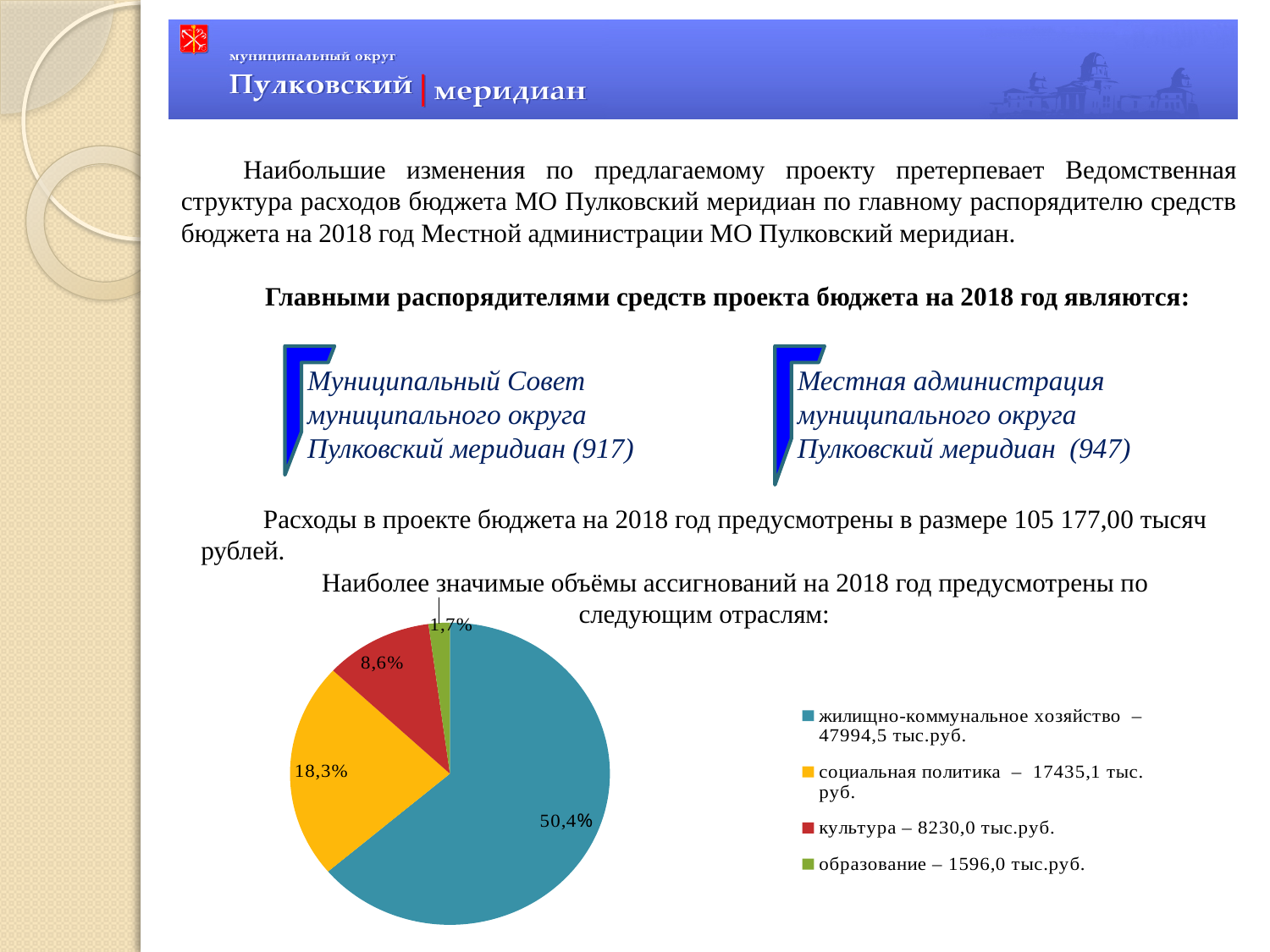
What is the difference in percentage points between the жилищно-коммунальное хозяйство slice and the социальная политика slice? 32,1% Which category has the smallest slice in the pie chart? образование What share of the pie does образование have? 1,7% How many slices does the pie chart have? 4 Which category has the largest slice in the pie chart? жилищно-коммунальное хозяйство Which slice is larger: социальная политика or культура? социальная политика What share of the pie does жилищно-коммунальное хозяйство have? 50,4% What share of the pie does социальная политика have? 18,3% According to the legend, what amount in тыс.руб. is allocated to культура? 8230,0 тыс.руб. How many entries does the legend of the pie chart list? 4 What kind of chart is shown on the slide? pie chart